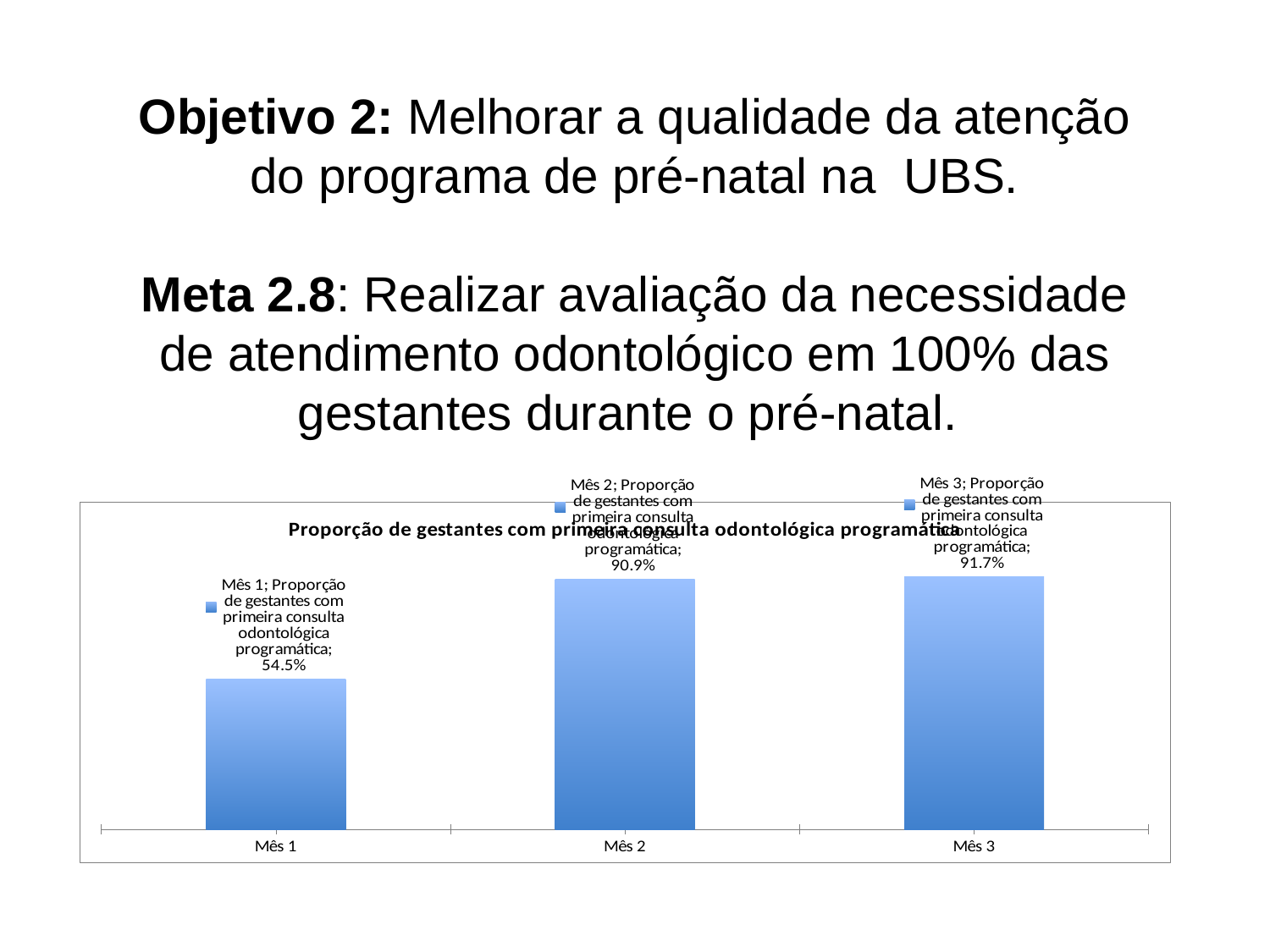
Which month has the highest value in the chart? Mês 3 What is the value for Mês 3 in the chart? 91.7% How many months (categories) are plotted in the chart? 3 Which is larger, the value for Mês 1 or the value for Mês 2? Mês 2 What is the title of the chart? Proporção de gestantes com primeira consulta odontológica programática Which month has the lowest value in the chart? Mês 1 Do the values rise or fall from Mês 1 to Mês 3? Rise What type of chart is shown on the slide? Bar chart What is the value for Mês 2 in the chart? 90.9% What is the difference between the values for Mês 3 and Mês 2? 0.8 percentage points What is the difference between the values for Mês 2 and Mês 1? 36.4 percentage points What is the value for Mês 1 in the chart? 54.5%